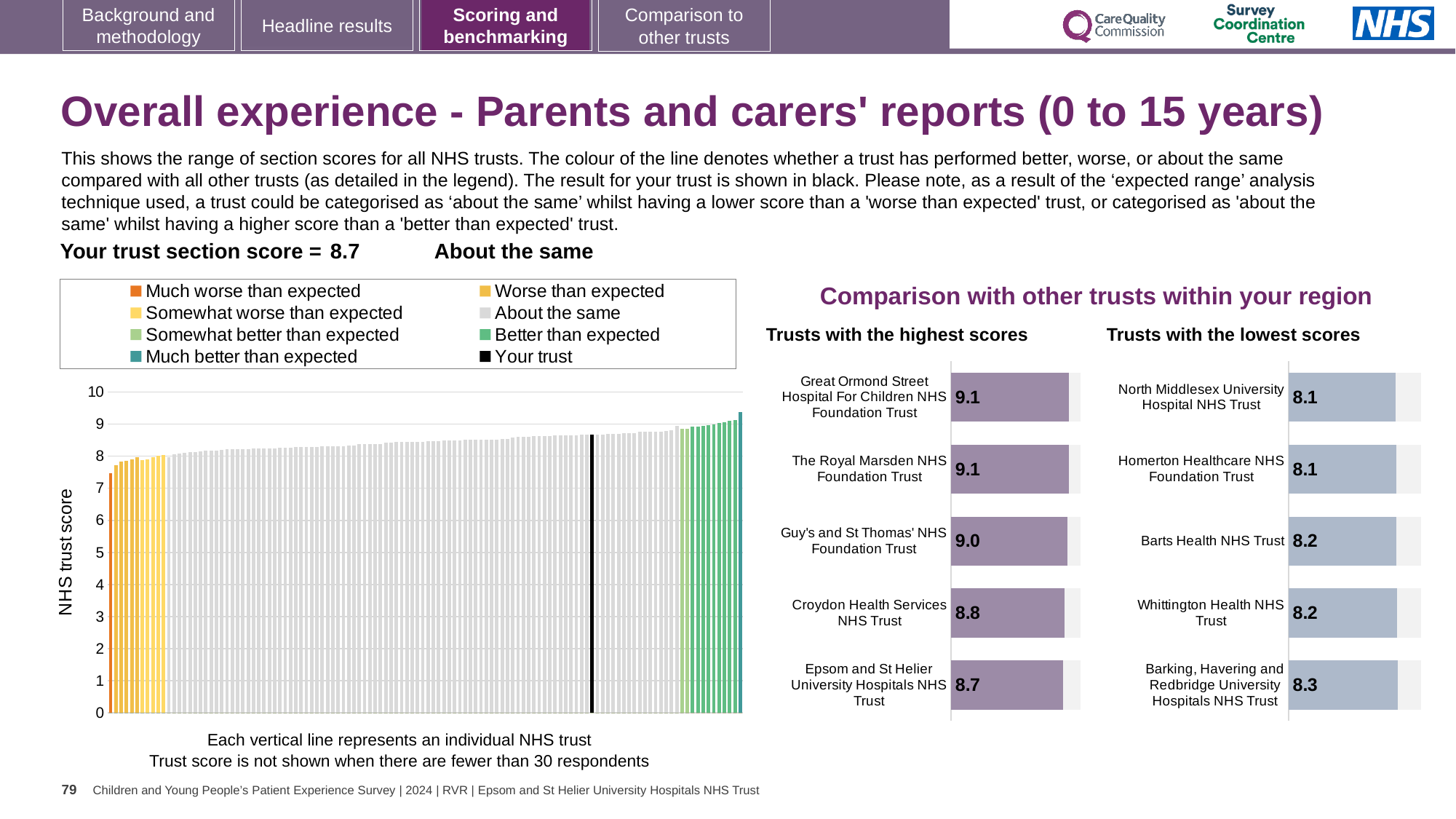
In the 'Trusts with the highest scores' chart, what is the score for Great Ormond Street Hospital For Children NHS Foundation Trust? 9.1 In the 'Trusts with the highest scores' chart, which trust has the lowest score? Epsom and St Helier University Hospitals NHS Trust In the 'Trusts with the lowest scores' chart, what is the difference between the scores of Barking, Havering and Redbridge University Hospitals NHS Trust and North Middlesex University Hospital NHS Trust? 0.2 What kind of chart is the large chart on the left showing NHS trust scores? Bar chart In the 'Trusts with the highest scores' chart, what is the score for Croydon Health Services NHS Trust? 8.8 In the 'Trusts with the lowest scores' chart, which has the larger score: Barts Health NHS Trust or Barking, Havering and Redbridge University Hospitals NHS Trust? Barking, Havering and Redbridge University Hospitals NHS Trust How many trusts are listed in the 'Trusts with the lowest scores' chart? 5 In the large chart on the left, is the value for the black 'Your trust' bar greater or less than 8? greater How many entries does the legend of the large chart on the left list? 8 In the 'Trusts with the lowest scores' chart, what is the score for Barking, Havering and Redbridge University Hospitals NHS Trust? 8.3 In the 'Trusts with the highest scores' chart, what is the difference between the scores of Great Ormond Street Hospital For Children NHS Foundation Trust and Epsom and St Helier University Hospitals NHS Trust? 0.4 In the 'Trusts with the lowest scores' chart, which trust has the highest score? Barking, Havering and Redbridge University Hospitals NHS Trust